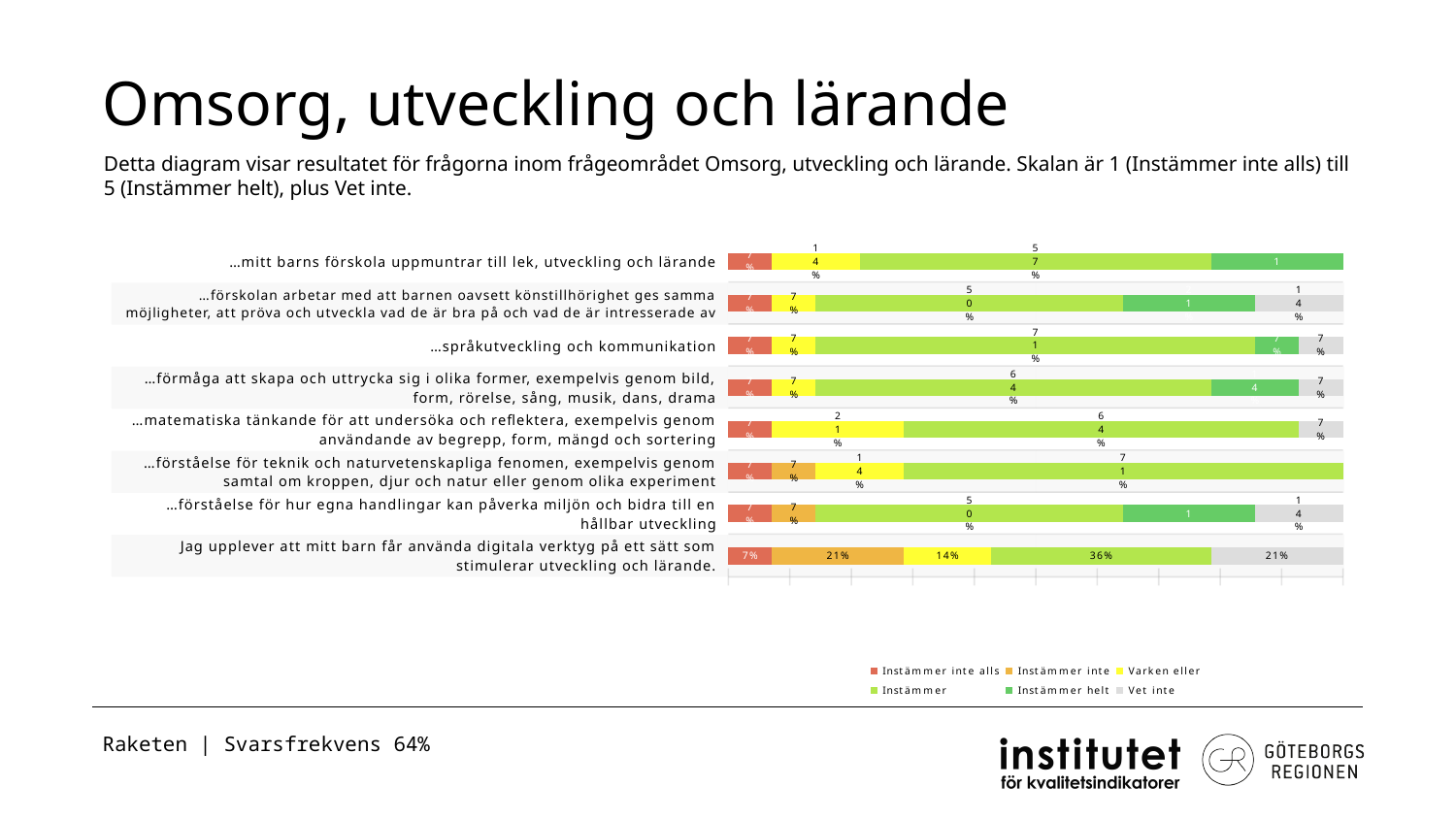
For the statement about digitala verktyg, what is the difference between the 'Instämmer' share and the 'Varken eller' share? 22% For the statement 'Jag upplever att mitt barn får använda digitala verktyg på ett sätt som stimulerar utveckling och lärande', what is the share for 'Instämmer'? 36% For the statement about digitala verktyg, which response category has the largest share? Instämmer For the statement about digitala verktyg, what is the share for 'Instämmer inte alls'? 7% For the statement about digitala verktyg, what is the share for 'Instämmer inte'? 21% For the statement about digitala verktyg, what is the share for 'Varken eller'? 14% For the statement about digitala verktyg, which is larger: the share for 'Instämmer' or the share for 'Varken eller'? Instämmer Which response category is shown in red in the legend? Instämmer inte alls How many question statements (categories) are plotted in the chart? 8 For the statement about digitala verktyg, what is the share for 'Vet inte'? 21% How many series does the legend list? 6 What kind of chart is shown on the slide? Stacked bar chart